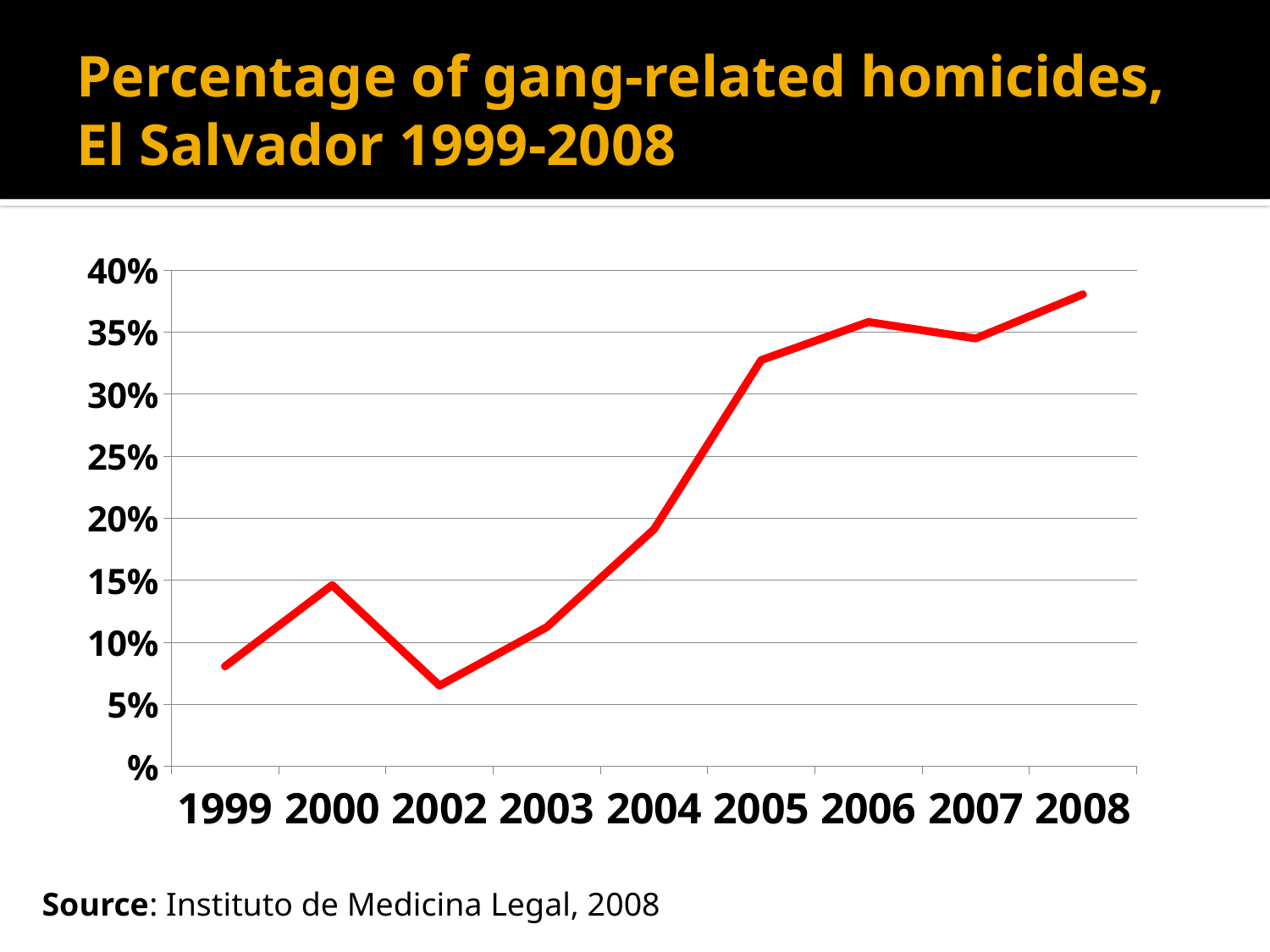
Is the value for 2005 greater or less than 30%? greater Which year has a higher percentage, 2004 or 2005? 2005 Which year has the highest percentage of gang-related homicides? 2008 What is the title of the chart? Percentage of gang-related homicides, El Salvador 1999-2008 Is the value for 2003 greater or less than 15%? less What kind of chart is shown on the slide? line chart Overall, does the percentage of gang-related homicides rise or fall from 1999 to 2008? rise Is the value for 2002 greater or less than 10%? less How many years are plotted along the x axis? 9 Which year has the lowest percentage of gang-related homicides? 2002